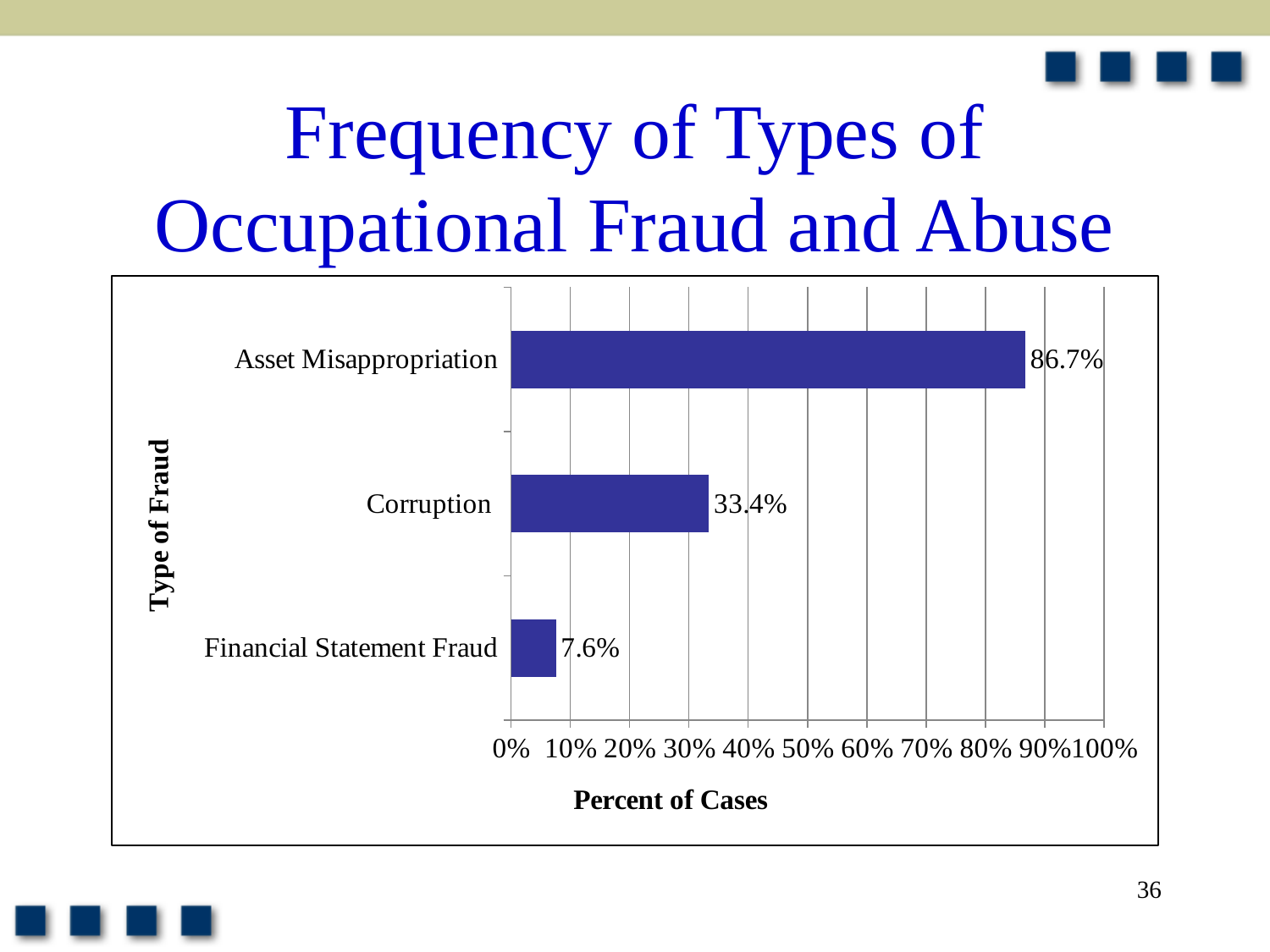
What is the value for Financial Statement Fraud? 7.6% Which type of fraud has the lowest percent of cases? Financial Statement Fraud What is the label of the horizontal axis? Percent of Cases What kind of chart is shown on the slide? bar chart What is the difference between the values for Corruption and Financial Statement Fraud? 25.8% Which is larger, the value for Corruption or the value for Financial Statement Fraud? Corruption Which type of fraud has the highest percent of cases? Asset Misappropriation What is the difference between the values for Asset Misappropriation and Corruption? 53.3% What is the value for Corruption? 33.4% How many types of fraud are shown in the chart? 3 Is the value for Corruption greater or less than 40%? less What is the value for Asset Misappropriation? 86.7%